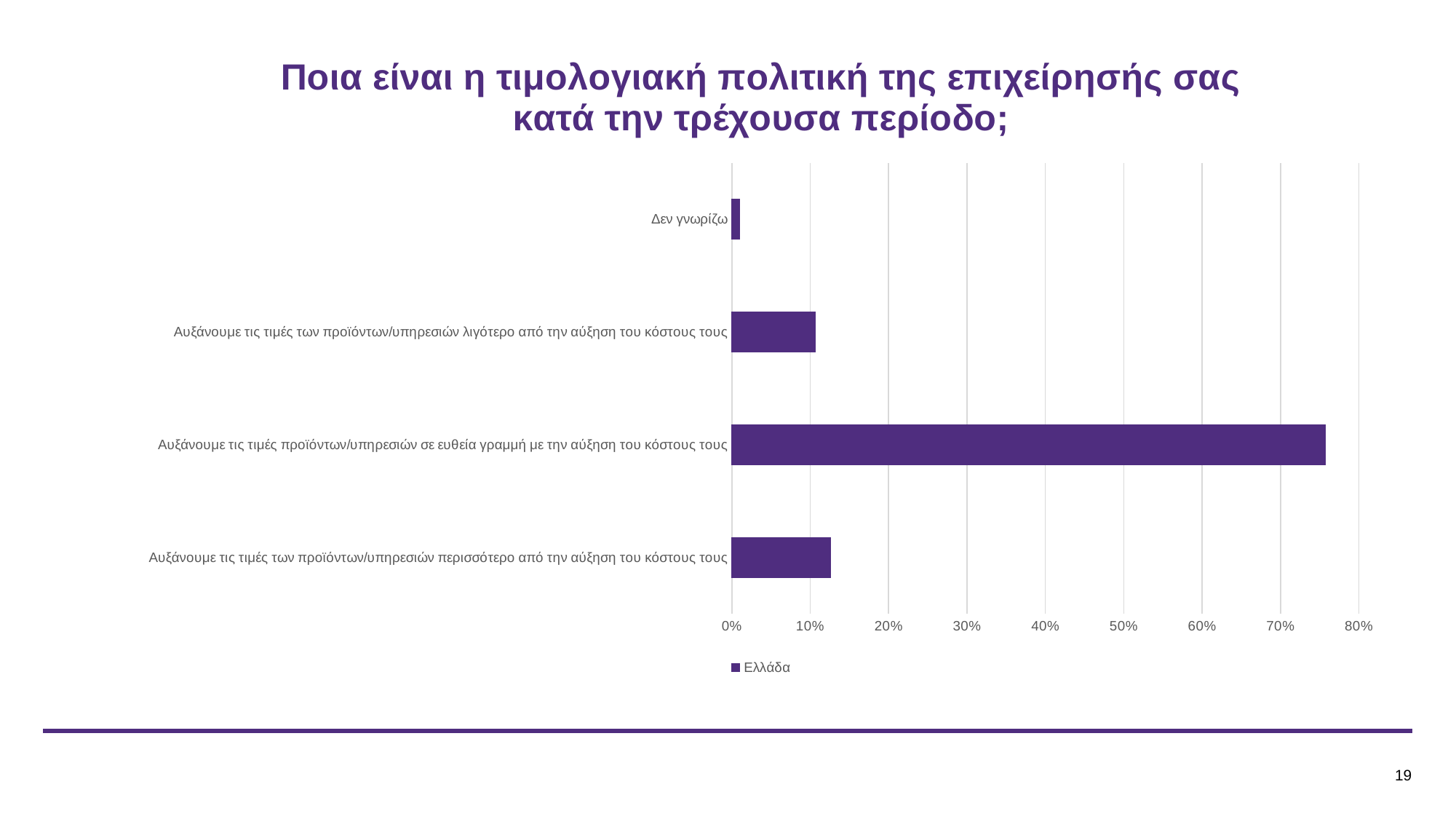
Is the value for 'Αυξάνουμε τις τιμές των προϊόντων/υπηρεσιών περισσότερο από την αύξηση του κόστους τους' greater or less than 20%? less What kind of chart is shown on the slide? Bar chart Which is larger: the value for 'Αυξάνουμε τις τιμές προϊόντων/υπηρεσιών σε ευθεία γραμμή με την αύξηση του κόστους τους' or the value for 'Αυξάνουμε τις τιμές των προϊόντων/υπηρεσιών περισσότερο από την αύξηση του κόστους τους'? Αυξάνουμε τις τιμές προϊόντων/υπηρεσιών σε ευθεία γραμμή με την αύξηση του κόστους τους Which category has the lowest value? Δεν γνωρίζω Is the value for 'Αυξάνουμε τις τιμές προϊόντων/υπηρεσιών σε ευθεία γραμμή με την αύξηση του κόστους τους' greater or less than 80%? less Is the value for 'Αυξάνουμε τις τιμές προϊόντων/υπηρεσιών σε ευθεία γραμμή με την αύξηση του κόστους τους' greater or less than 70%? greater How many categories are shown in the chart? 4 How many series does the legend list? 1 What is the name of the series shown in the legend? Ελλάδα Which category has the highest value? Αυξάνουμε τις τιμές προϊόντων/υπηρεσιών σε ευθεία γραμμή με την αύξηση του κόστους τους